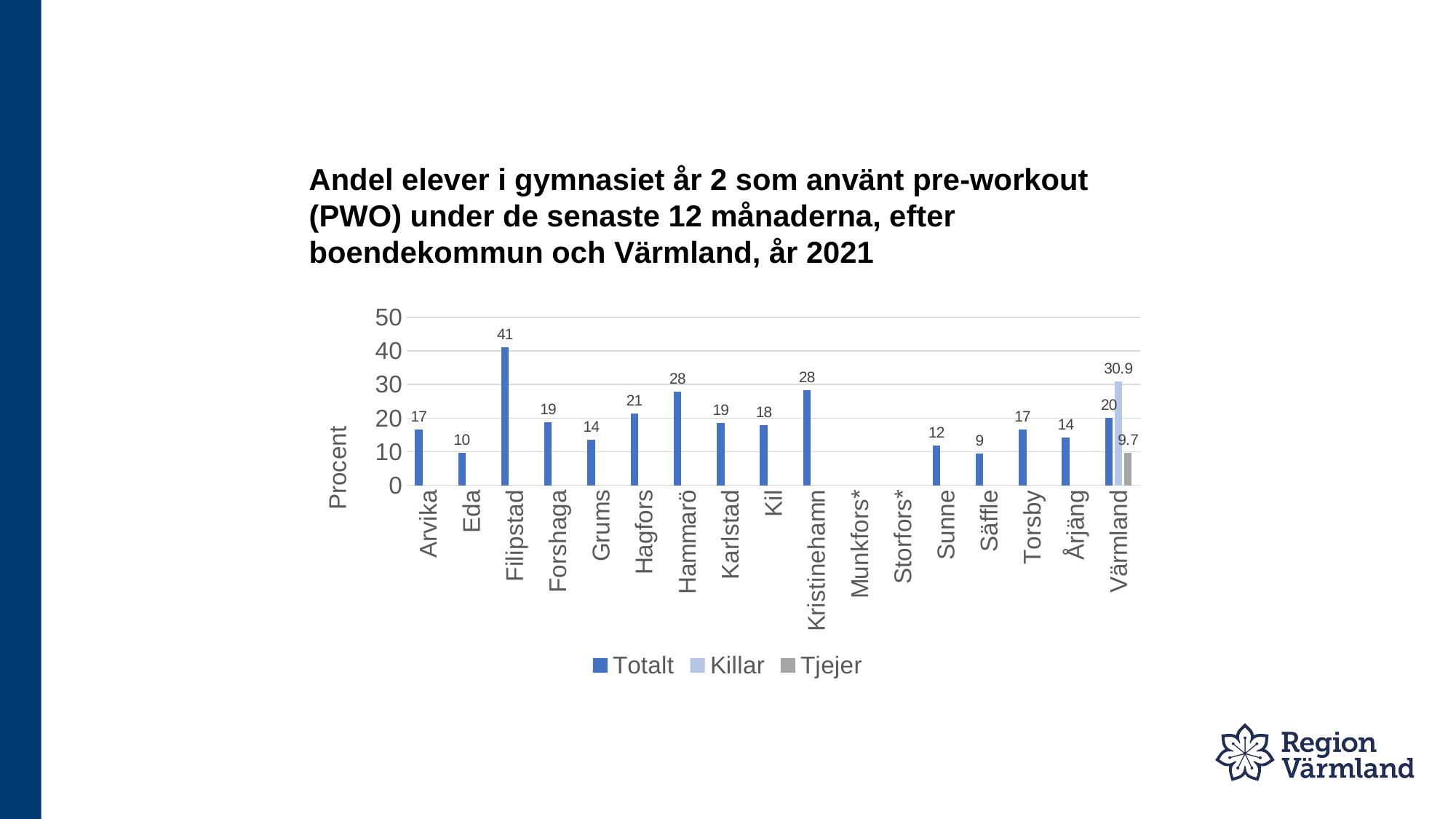
What is the Tjejer value for Värmland? 9.7 What kind of chart is shown on the slide? bar chart How many categories are shown on the x axis? 17 What is the Totalt value for Filipstad? 41 What is the label of the y axis? Procent How many series does the legend list? 3 Which municipality has the highest Totalt value? Filipstad Is the Totalt value for Hammarö greater or less than 20? greater Which has a higher Totalt value, Hagfors or Grums? Hagfors What is the Killar value for Värmland? 30.9 Which municipality with a plotted bar has the lowest Totalt value? Säffle What is the difference between the Totalt values for Filipstad and Eda? 31